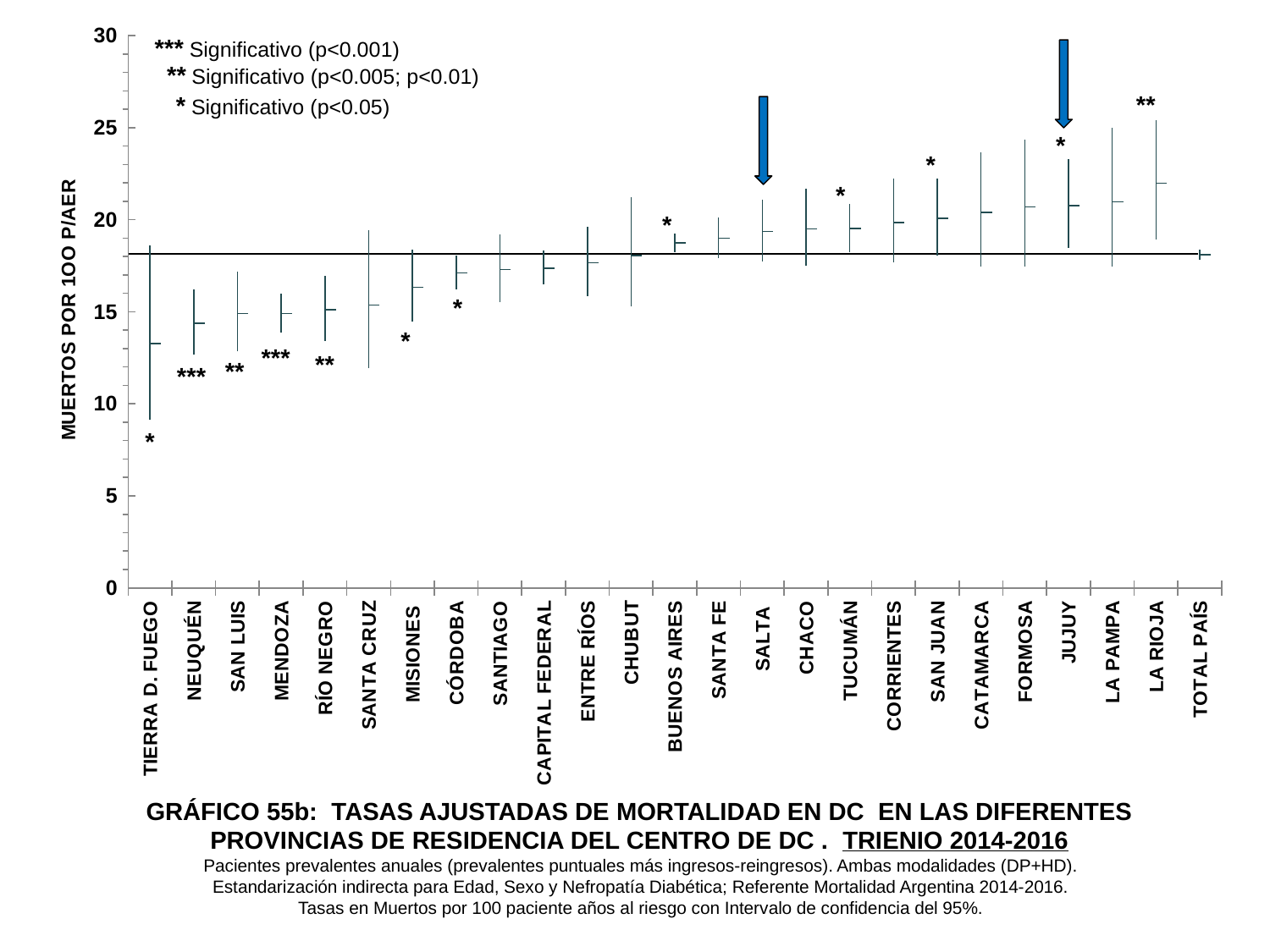
Is the point estimate for MISIONES greater or less than 15? greater Which category has the lowest point estimate in the chart? TIERRA D. FUEGO Do the point estimates generally rise or fall moving left to right along the x axis? rise Which two categories are marked with blue arrows above them? SALTA and JUJUY Is the point estimate for LA RIOJA greater or less than 20? greater How many categories are shown along the x axis of the chart? 25 Which category has the highest point estimate in the chart? LA RIOJA Is the point estimate for BUENOS AIRES greater or less than 20? less What is the label of the y axis? MUERTOS POR 1OO P/AER Which has the larger point estimate, MENDOZA or CHACO? CHACO